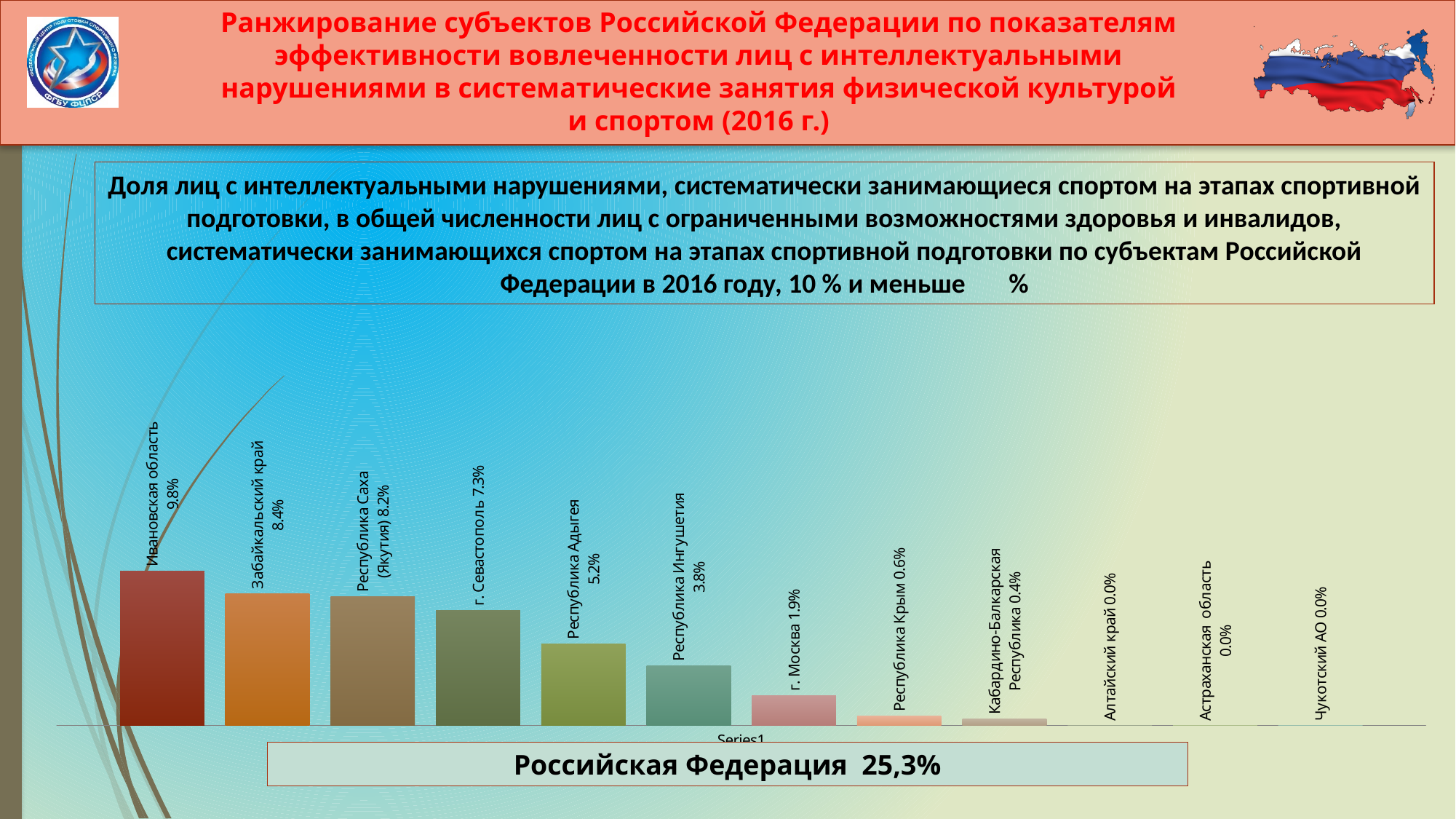
What kind of chart is shown on the slide? bar chart What value is given for the Российская Федерация in the box below the chart? 25,3% What is the difference between the values for Ивановская область and Забайкальский край? 1.4% Which region has the highest value in the chart? Ивановская область Which is larger, the value for г. Севастополь or for Республика Адыгея? г. Севастополь What is the value for Республика Саха (Якутия)? 8.2% What is the value for Кабардино-Балкарская Республика? 0.4% How many regions have a value of 0.0%? 3 What is the value for Ивановская область? 9.8% What is the value for г. Москва? 1.9% Do the values rise or fall from left to right across the chart? fall How many regions are shown in the chart? 12